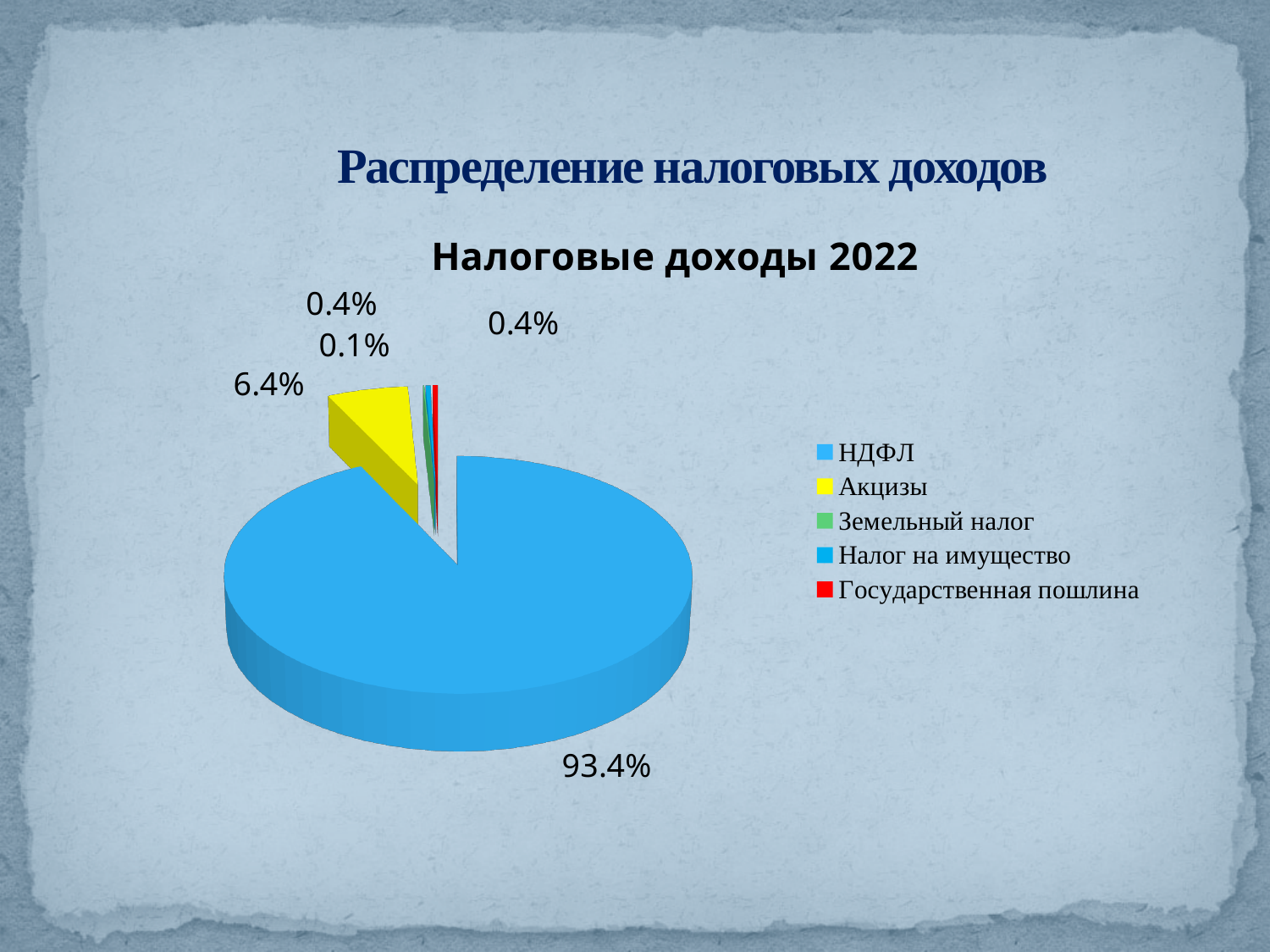
How many categories does the legend list? 5 How many data labels on the pie show a value of 0.4%? 2 What is the difference between the share for НДФЛ and the share for Акцизы? 87.0% What is the smallest percentage value labelled on the pie? 0.1% What colour is the slice for Акцизы? yellow What share of the pie does НДФЛ account for? 93.4% Which category has the largest slice of the pie? НДФЛ What is the title of the chart? Налоговые доходы 2022 What is the value shown for Акцизы? 6.4% What type of chart is shown on the slide? pie chart Which is larger, the share for НДФЛ or the share for Акцизы? НДФЛ